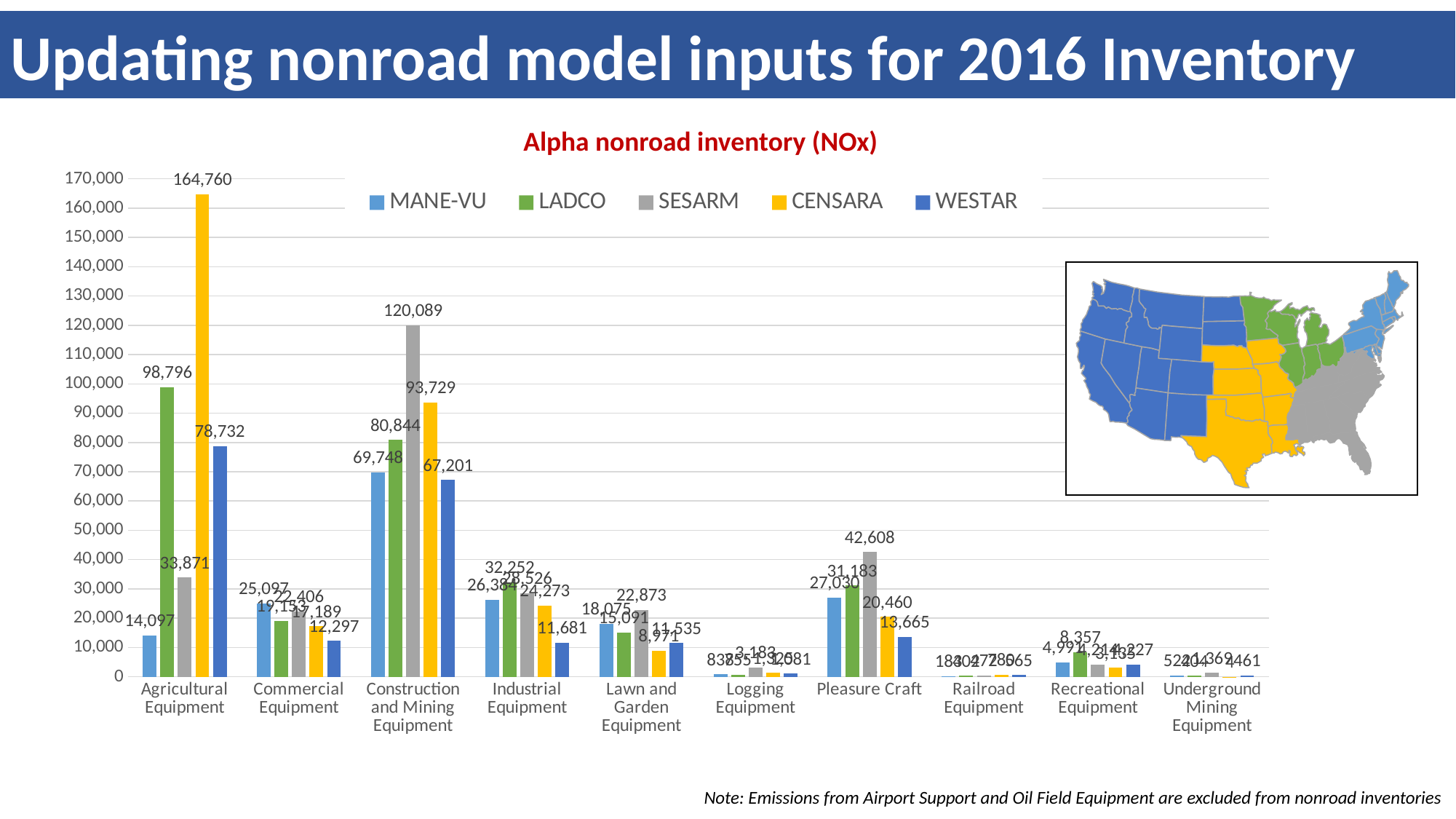
Is the SESARM value for Pleasure Craft greater or less than 40,000? greater What kind of chart is shown on the slide? bar chart What is the difference between the CENSARA and WESTAR values for Agricultural Equipment? 86,028 What is the SESARM value for Construction and Mining Equipment? 120,089 Which is larger: the LADCO value for Agricultural Equipment or the CENSARA value for Construction and Mining Equipment? LADCO value for Agricultural Equipment Which series has the lowest value for Construction and Mining Equipment? WESTAR Which series has the highest value for Agricultural Equipment? CENSARA How many equipment categories are shown on the x axis? 10 How many series does the legend list? 5 What is the title of the chart? Alpha nonroad inventory (NOx) What is the WESTAR value for Pleasure Craft? 13,665 What is the CENSARA value for Agricultural Equipment? 164,760